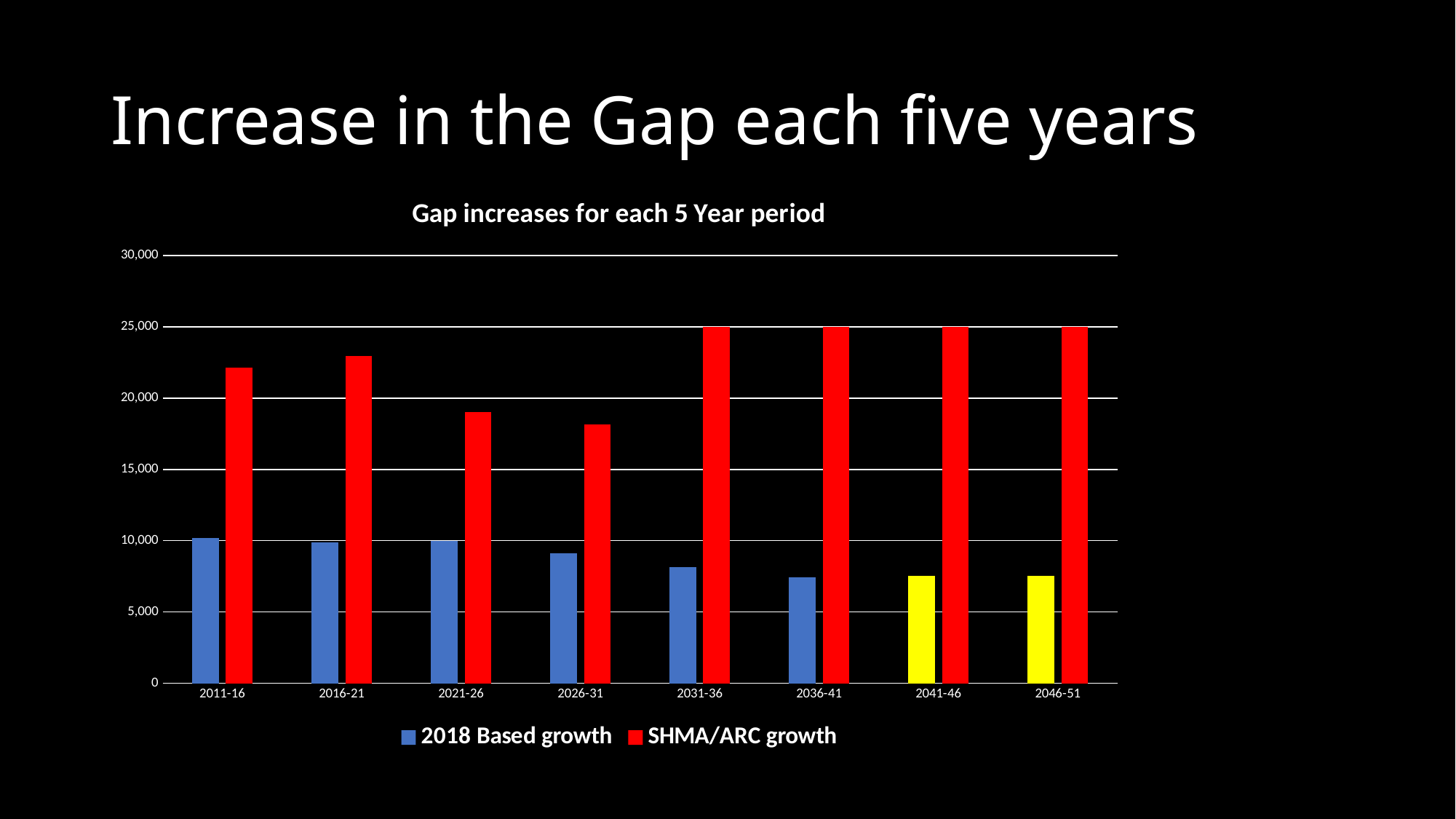
Is the 2018 Based growth value for 2036-41 greater or less than 10,000? less How many series does the legend list? 2 Which period has the lowest SHMA/ARC growth value? 2026-31 Is the SHMA/ARC growth value for 2021-26 greater or less than 20,000? less For 2011-16, which series has the larger value, 2018 Based growth or SHMA/ARC growth? SHMA/ARC growth Is the SHMA/ARC growth value for 2026-31 greater or less than 15,000? greater How many five-year periods are shown on the x axis? 8 What kind of chart is shown on the slide? Bar chart Which periods have their 2018 Based growth bars coloured yellow instead of blue? 2041-46 and 2046-51 What is the title of the chart? Gap increases for each 5 Year period What is the SHMA/ARC growth value for 2031-36? 25,000